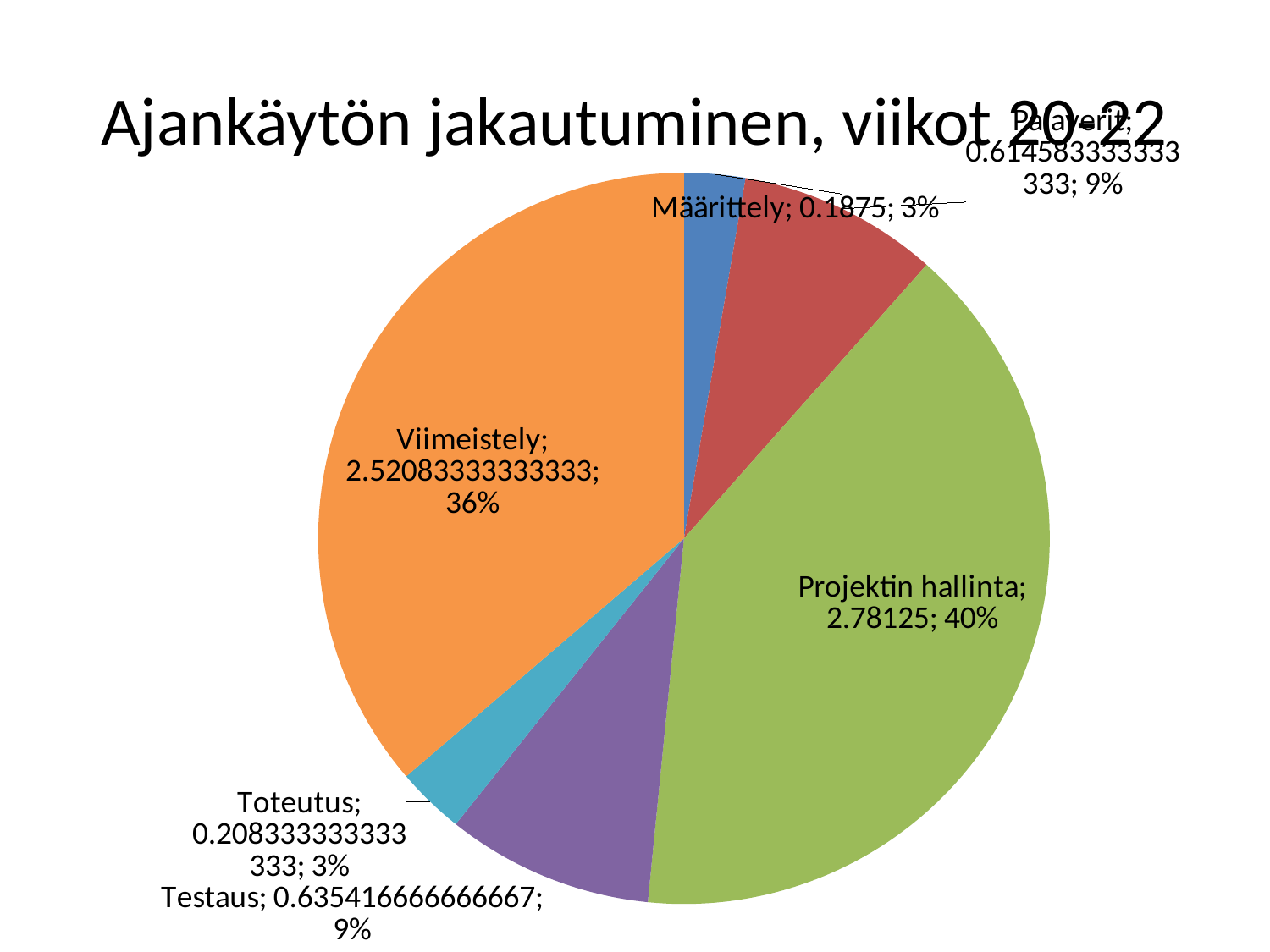
Which category has the largest slice of the pie? Projektin hallinta How many slices does the pie chart have? 6 What kind of chart is shown on the slide? pie chart What share of the pie does Viimeistely represent? 36% What is the value shown for Viimeistely? 2.52083333333333 What share of the pie does Testaus represent? 9% Which is larger, the slice for Viimeistely or the slice for Projektin hallinta? Projektin hallinta What is the title of the chart? Ajankäytön jakautuminen, viikot 20-22 What is the value shown for Määrittely? 0.1875 What is the value shown for Projektin hallinta? 2.78125 By how many percentage points does the share of Projektin hallinta exceed the share of Viimeistely? 4 What share of the pie does Projektin hallinta represent? 40%